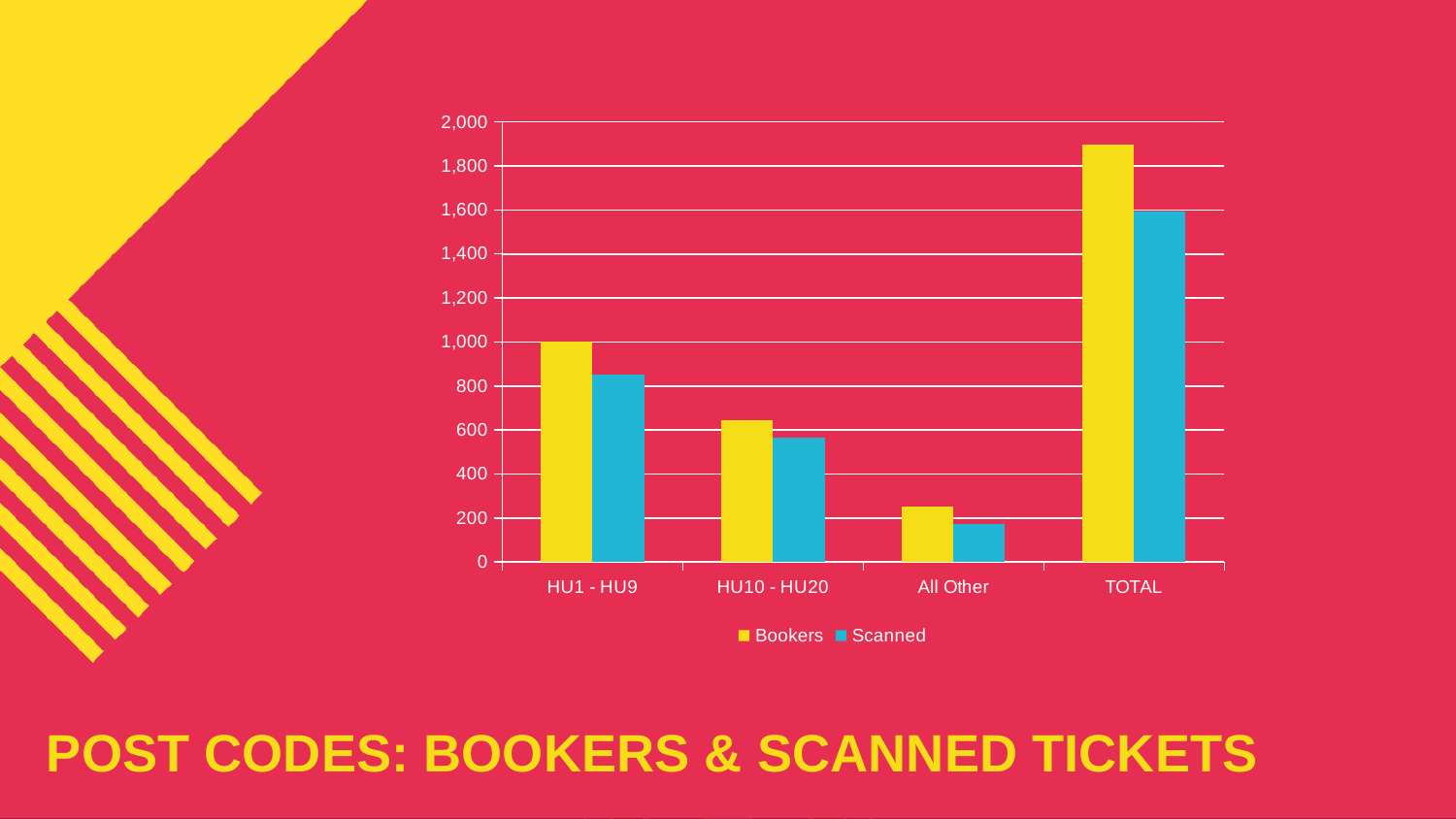
How many categories are shown on the x axis? 4 How many series does the legend list? 2 Is the Bookers value for HU10 - HU20 greater or less than 600? greater Is the Scanned value for HU1 - HU9 greater or less than 800? greater Is the Scanned value for TOTAL greater or less than 1,400? greater Which category has the lowest Scanned value? All Other Which category has the highest Bookers value? TOTAL Which colour represents the Scanned series in the legend? blue For HU1 - HU9, which is larger: Bookers or Scanned? Bookers What kind of chart is shown on the slide? bar chart